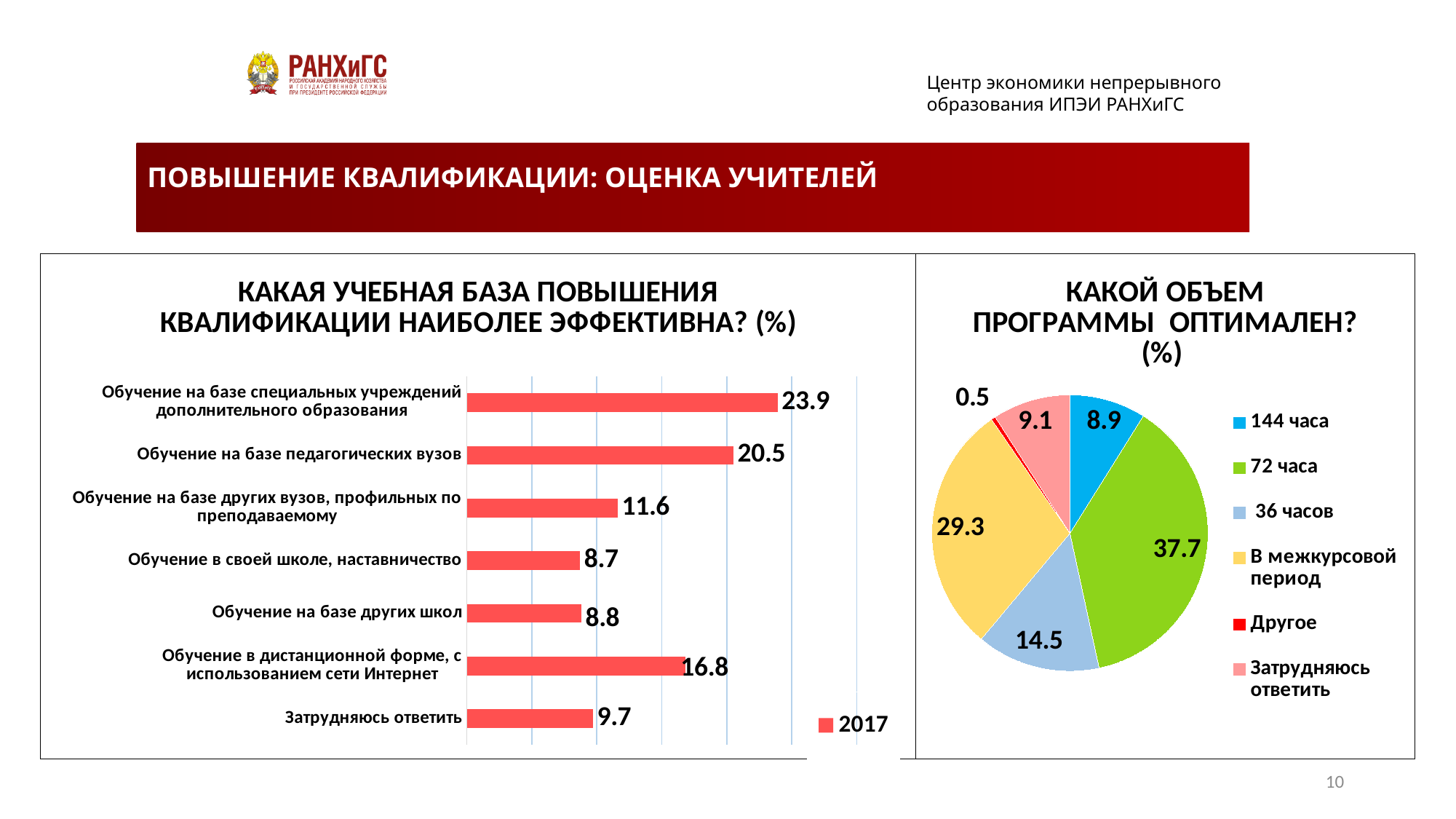
In the left chart 'Какая учебная база повышения квалификации наиболее эффективна? (%)', how many categories are shown? 7 In the right pie chart 'Какой объем программы оптимален? (%)', how many categories does the legend list? 6 What type of chart is the left chart 'Какая учебная база повышения квалификации наиболее эффективна? (%)'? Bar chart In the left chart 'Какая учебная база повышения квалификации наиболее эффективна? (%)', what is the value for 'Обучение на базе педагогических вузов'? 20.5 In the left chart 'Какая учебная база повышения квалификации наиболее эффективна? (%)', which category has the lowest value? Обучение в своей школе, наставничество In the right pie chart 'Какой объем программы оптимален? (%)', what is the value for '72 часа'? 37.7 In the left chart 'Какая учебная база повышения квалификации наиболее эффективна? (%)', which category has the highest value? Обучение на базе специальных учреждений дополнительного образования In the left chart 'Какая учебная база повышения квалификации наиболее эффективна? (%)', what is the value for 'Обучение в дистанционной форме, с использованием сети Интернет'? 16.8 In the right pie chart 'Какой объем программы оптимален? (%)', what is the value for 'В межкурсовой период'? 29.3 In the left chart 'Какая учебная база повышения квалификации наиболее эффективна? (%)', what year does the legend show? 2017 In the right pie chart 'Какой объем программы оптимален? (%)', which category has the smallest slice? Другое In the left chart 'Какая учебная база повышения квалификации наиболее эффективна? (%)', what is the difference between 'Обучение на базе специальных учреждений дополнительного образования' and 'Обучение на базе педагогических вузов'? 3.4